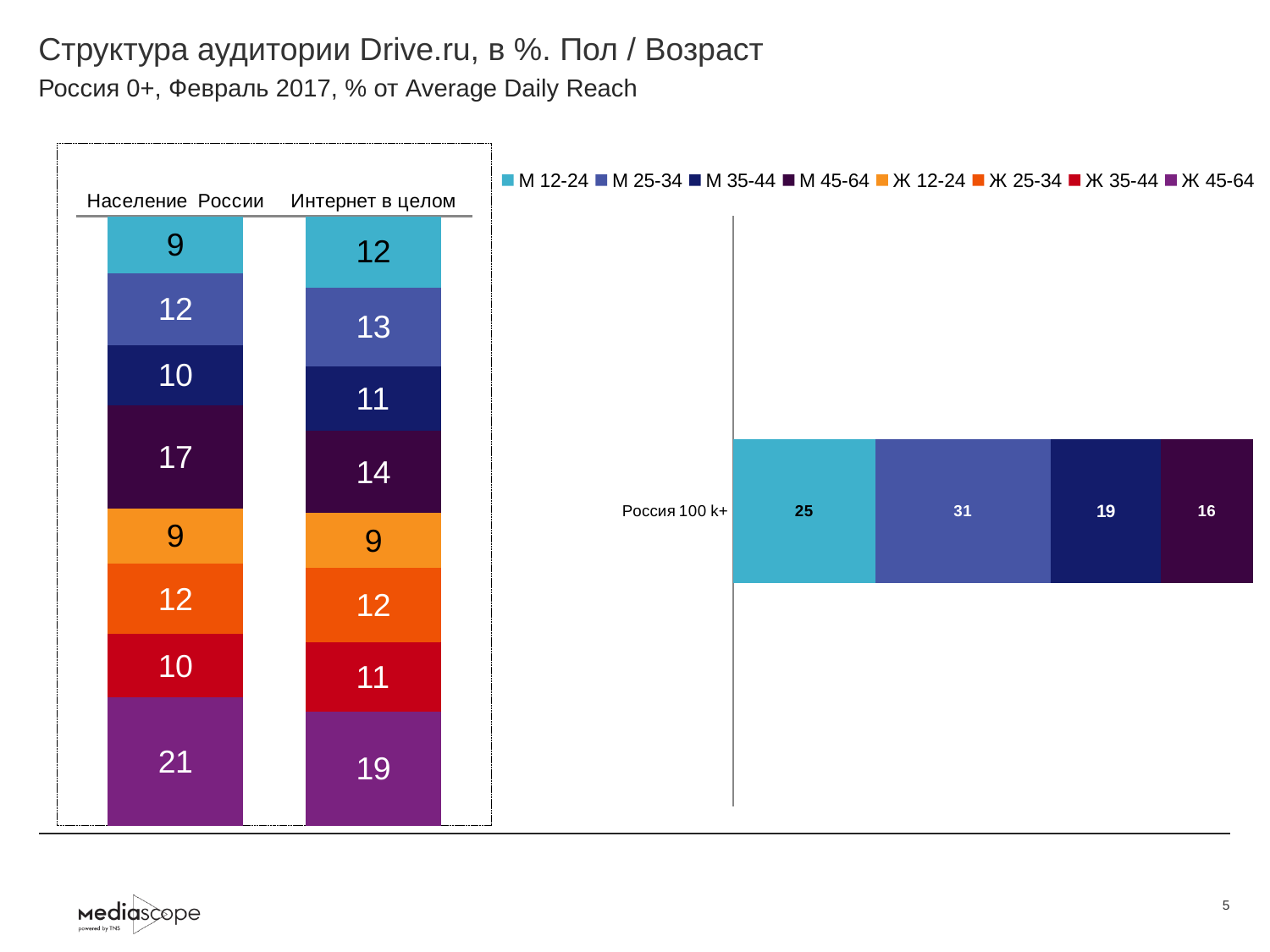
In the right chart, what is the value of the M 25-34 segment for Россия 100 k+? 31 What kind of chart is the right chart? Stacked bar chart In the left chart, which is larger for M 12-24: Население России or Интернет в целом? Интернет в целом In the right chart, what is the total of the four labelled segments of the Россия 100 k+ bar? 91 How many series does the legend list? 8 In the left chart, what is the difference between the Ж 45-64 values for Население России and Интернет в целом? 2 In the right chart, which segment of the Россия 100 k+ bar has the largest value? M 25-34 In the left chart, what is the value of the Ж 45-64 segment for Интернет в целом? 19 In the right chart, which segment of the Россия 100 k+ bar has the smallest value? M 45-64 In the right chart, what is the difference between the M 12-24 and M 35-44 values for Россия 100 k+? 6 In the left chart, what is the value of the M 45-64 segment for Население России? 17 How many bars are shown in the left chart? 2